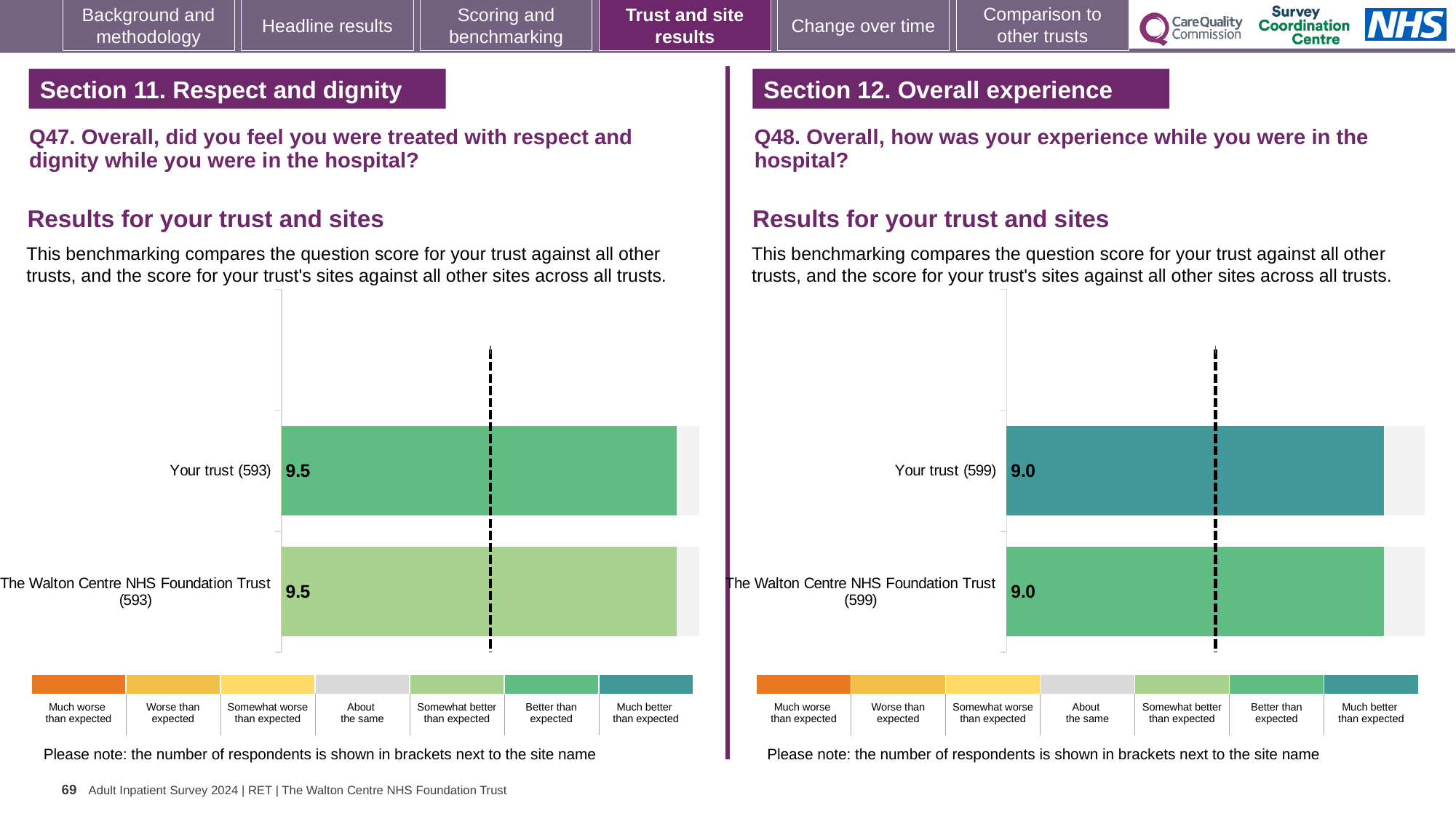
On the Q47 chart (left), what is the score for The Walton Centre NHS Foundation Trust (593)? 9.5 On the Q48 chart (right), what is the score for The Walton Centre NHS Foundation Trust (599)? 9.0 What type of chart is used on the Q47 chart (left)? Bar chart On the Q47 chart (left), how many respondents are shown in brackets for Your trust? 593 How many bars are plotted on the Q48 chart (right)? 2 On the Q47 chart (left), what is the difference between the score for Your trust and the score for The Walton Centre NHS Foundation Trust? 0.0 On the Q47 chart (left), what is the score for Your trust (593)? 9.5 On the Q48 chart (right), what is the difference between the score for Your trust and the score for The Walton Centre NHS Foundation Trust? 0.0 On the Q48 chart (right), what is the score for Your trust (599)? 9.0 On the Q48 chart (right), which benchmark category does the colour of the Your trust bar correspond to in the legend? Much better than expected How many bars are plotted on the Q47 chart (left)? 2 Is the score for Your trust on the Q48 chart (right) larger or smaller than the score for Your trust on the Q47 chart (left)? Smaller